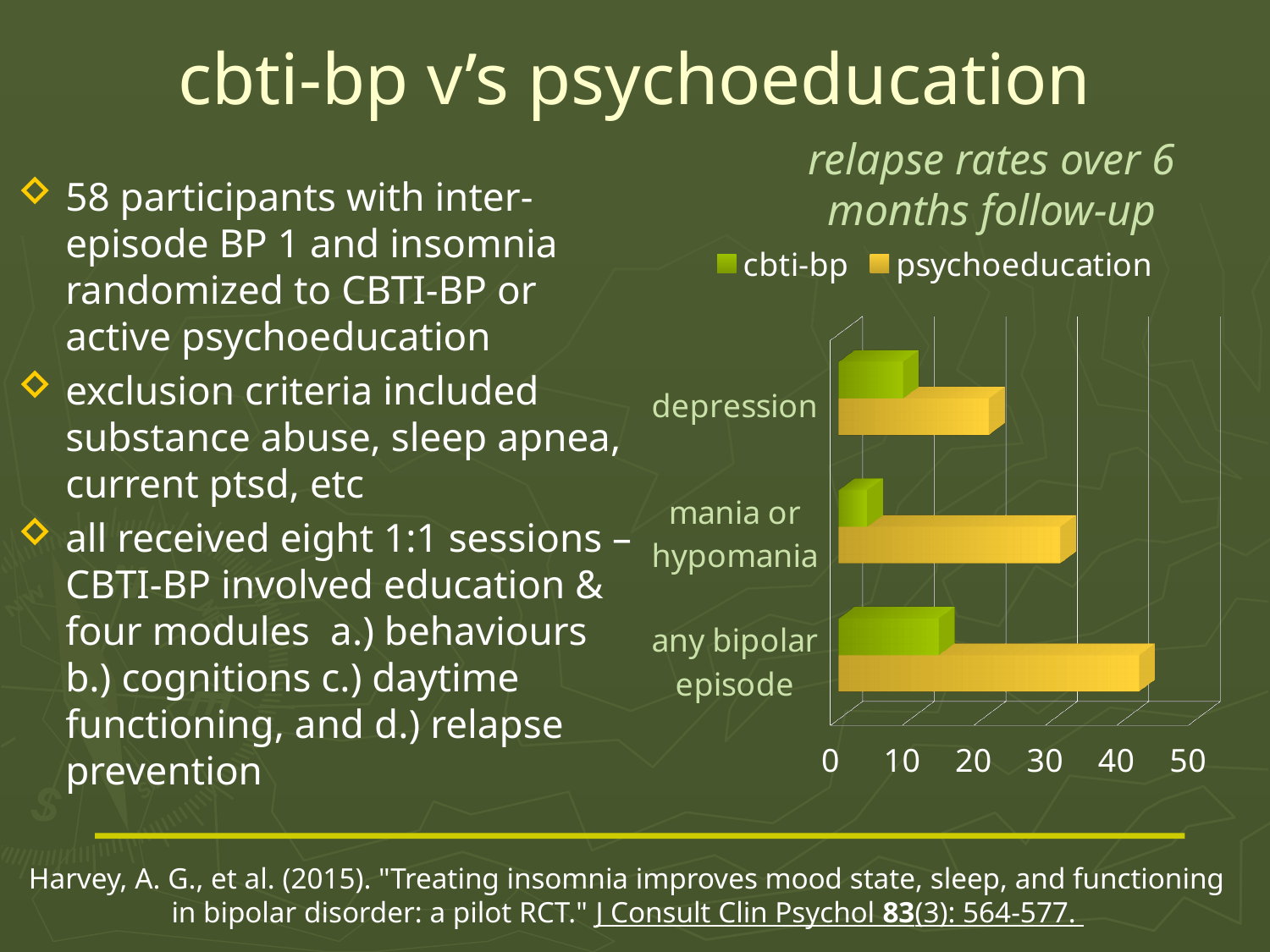
How many series does the chart legend list? 2 Is the psychoeducation value for mania or hypomania greater or less than 20? greater Which category has the lowest cbti-bp relapse rate? mania or hypomania Which category has the highest psychoeducation relapse rate? any bipolar episode How many categories are shown on the chart? 3 For mania or hypomania, which series has the larger value, cbti-bp or psychoeducation? psychoeducation Is the cbti-bp value for mania or hypomania greater or less than 10? less For depression, which series has the larger value, cbti-bp or psychoeducation? psychoeducation Is the cbti-bp value for depression greater or less than 20? less What kind of chart is shown on the slide? bar chart What is the title of the chart? relapse rates over 6 months follow-up